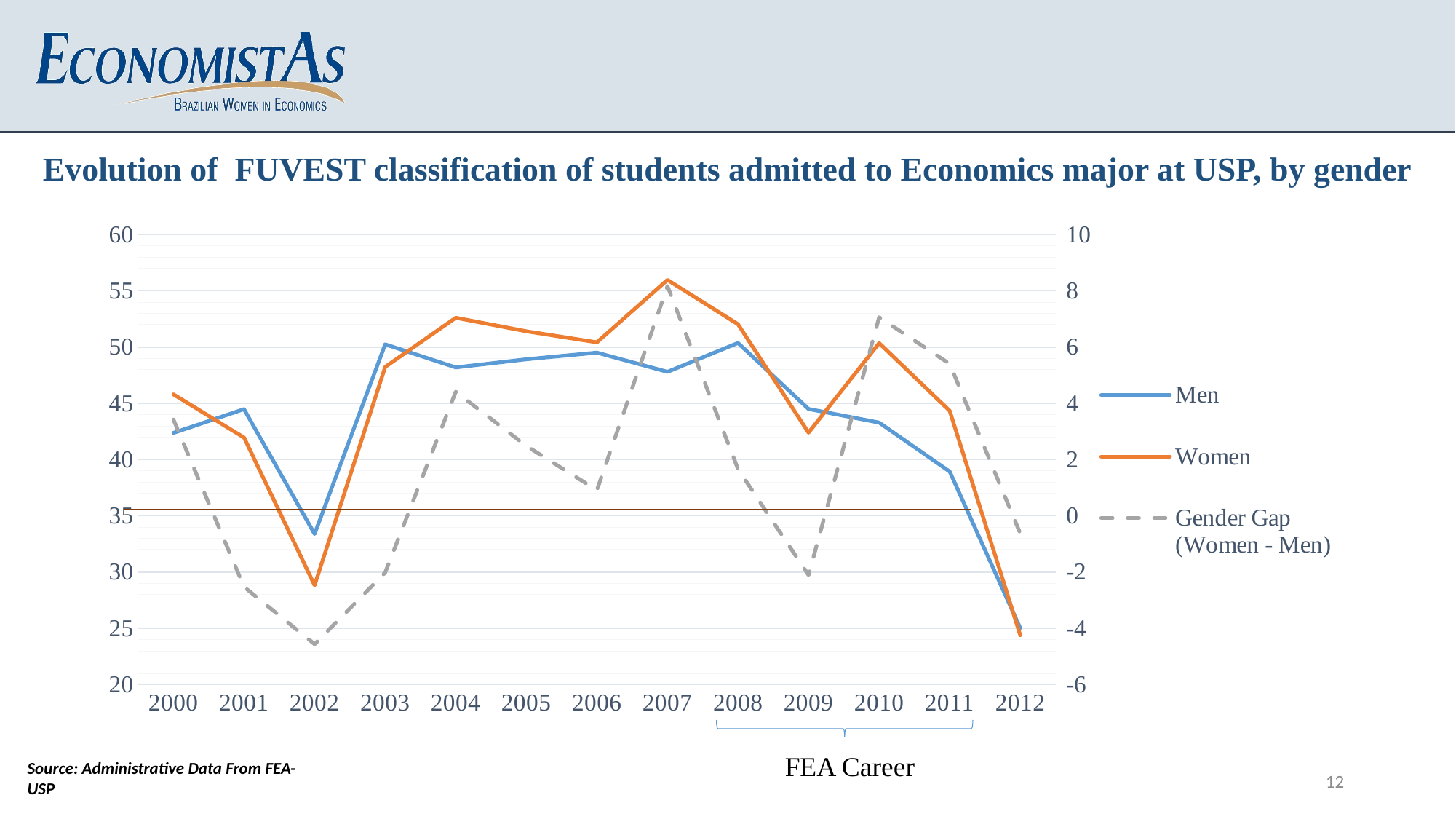
In 2002, which series has the higher value, Men or Women? Men What kind of chart is shown on the slide? Line chart Is the value for Men in 2002 greater or less than 35? less What is the title of the chart? Evolution of FUVEST classification of students admitted to Economics major at USP, by gender How many series does the legend list? 3 Which series are listed in the legend? Men, Women, Gender Gap (Women - Men) How many years are plotted along the x axis? 13 Is the value for Women in 2007 greater or less than 55? greater In which year does the Men series reach its lowest value? 2012 In which year does the Women series reach its highest value? 2007 Is the Gender Gap (Women - Men) value in 2009 greater or less than 0? less Does the Men series rise or fall from 2008 to 2012? Fall